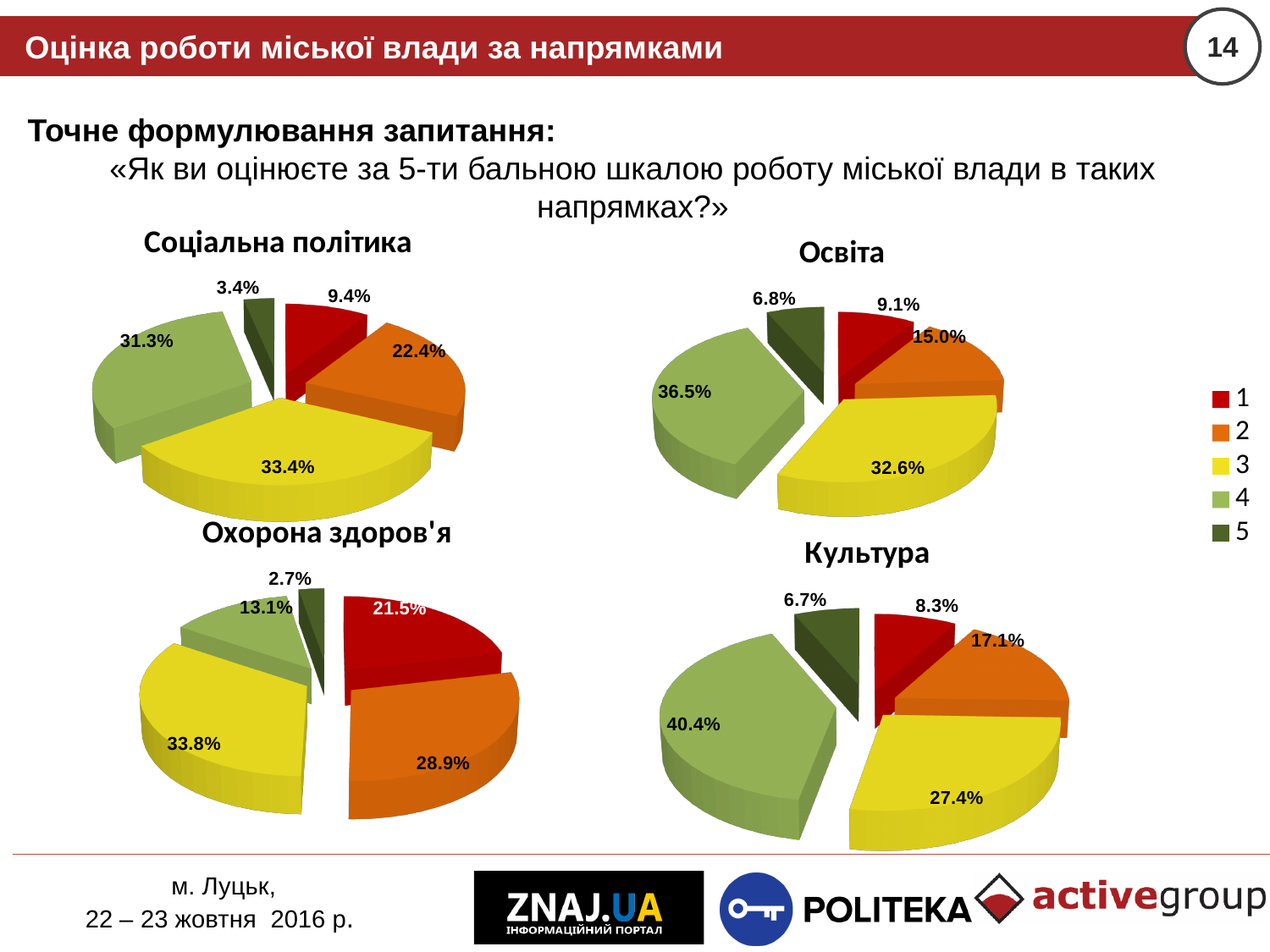
In the 'Освіта' pie chart, what share is shown for rating 4? 36.5% In the 'Охорона здоров'я' pie chart, what share is shown for rating 1? 21.5% What type of chart is used for 'Освіта'? pie chart In the 'Соціальна політика' pie chart, what share is shown for rating 3? 33.4% In the 'Соціальна політика' pie chart, what is the difference between the shares for rating 2 and rating 1? 13.0% How many slices does the 'Культура' pie chart have? 5 In the 'Освіта' pie chart, which is larger: the share for rating 2 or the share for rating 3? rating 3 In the 'Культура' pie chart, which rating has the largest share? 4 How many pie charts are shown on the slide? 4 In the 'Культура' pie chart, what share is shown for rating 5? 6.7% In the 'Охорона здоров'я' pie chart, which rating has the smallest share? 5 How many entries does the legend list? 5